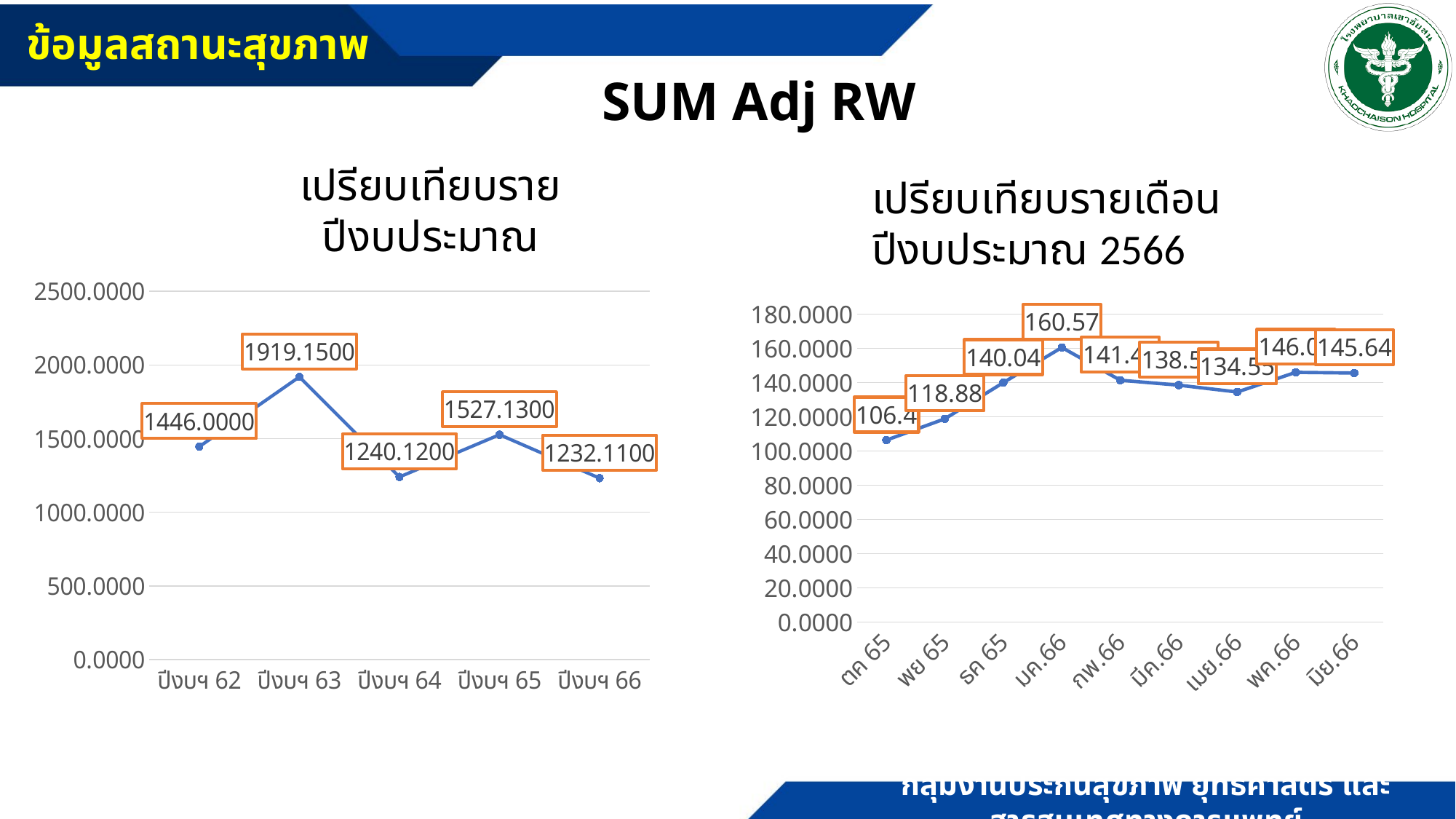
In the left chart (เปรียบเทียบรายปีงบประมาณ), what is the difference between the values for ปีงบฯ 63 and ปีงบฯ 62? 473.1500 In the left chart (เปรียบเทียบรายปีงบประมาณ), which fiscal year has the highest value? ปีงบฯ 63 In the left chart (เปรียบเทียบรายปีงบประมาณ), how many fiscal years are plotted? 5 In the left chart (เปรียบเทียบรายปีงบประมาณ), is the value for ปีงบฯ 65 greater or less than 1500.0000? greater In the right chart (เปรียบเทียบรายเดือนปีงบประมาณ 2566), what is the value for มค.66? 160.57 In the right chart (เปรียบเทียบรายเดือนปีงบประมาณ 2566), which month has the highest value? มค.66 In the left chart (เปรียบเทียบรายปีงบประมาณ), what is the value for ปีงบฯ 66? 1232.1100 In the left chart (เปรียบเทียบรายปีงบประมาณ), what is the value for ปีงบฯ 63? 1919.1500 In the right chart (เปรียบเทียบรายเดือนปีงบประมาณ 2566), what is the value for มิย.66? 145.64 What kind of chart is the right chart (เปรียบเทียบรายเดือนปีงบประมาณ 2566)? line chart In the left chart (เปรียบเทียบรายปีงบประมาณ), which fiscal year has the lowest value? ปีงบฯ 66 In the right chart (เปรียบเทียบรายเดือนปีงบประมาณ 2566), how many months are plotted? 9